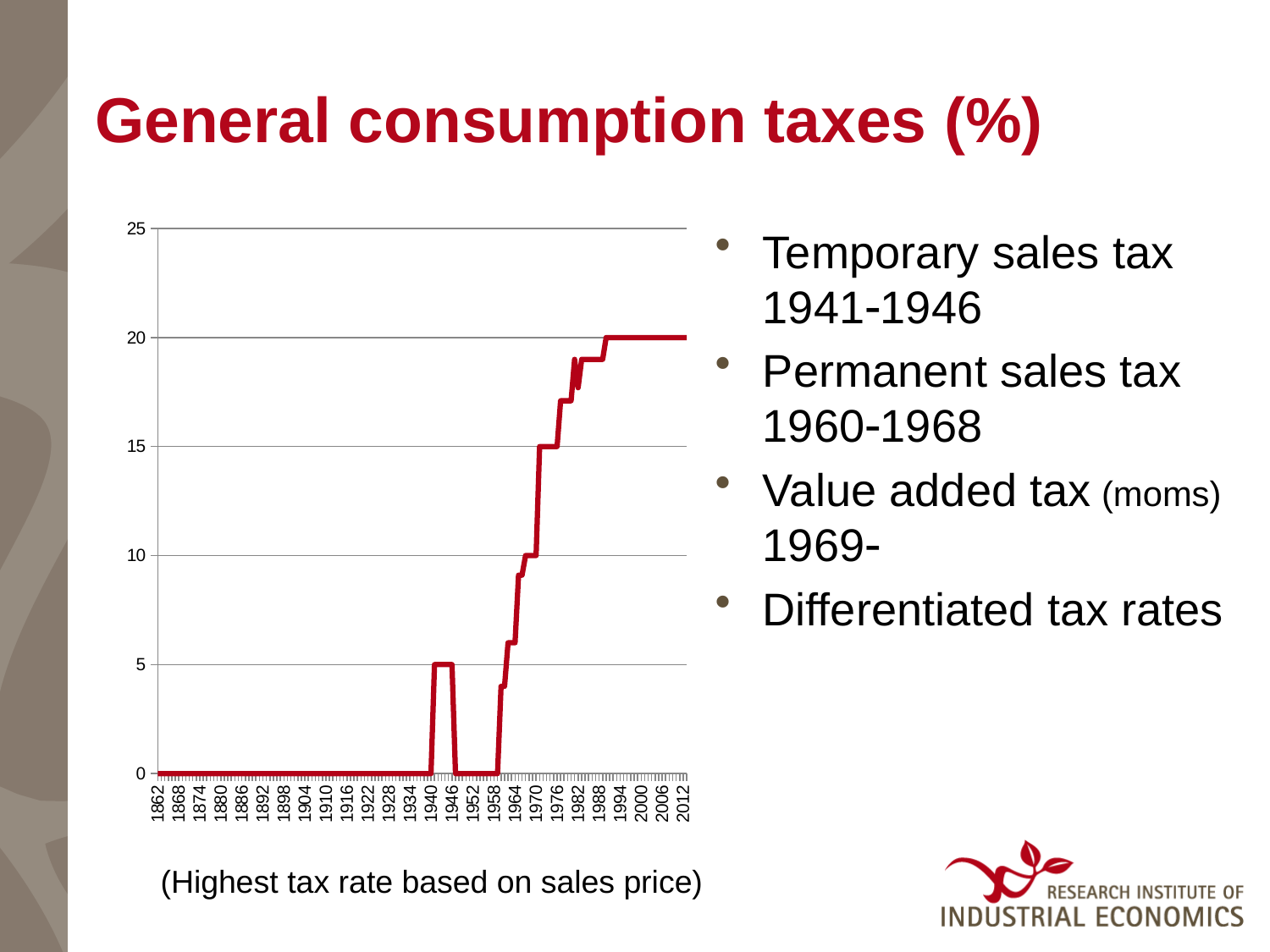
Is the value for 1982 greater or less than 15? greater What is the value of the line in 1862? 0 What is the lowest value the line reaches? 0 What is the highest value the line reaches? 20 What is the value of the line in 2012? 20 What is the difference between the value in 2012 and the value in 1944? 15 Which year has the larger value, 1944 or 1952? 1944 What kind of chart is shown on the slide? line chart What is the value of the line in 1952? 0 What is the title of the chart? General consumption taxes (%) What is the value of the line in 1944? 5 Is the value for 1964 greater or less than 10? less